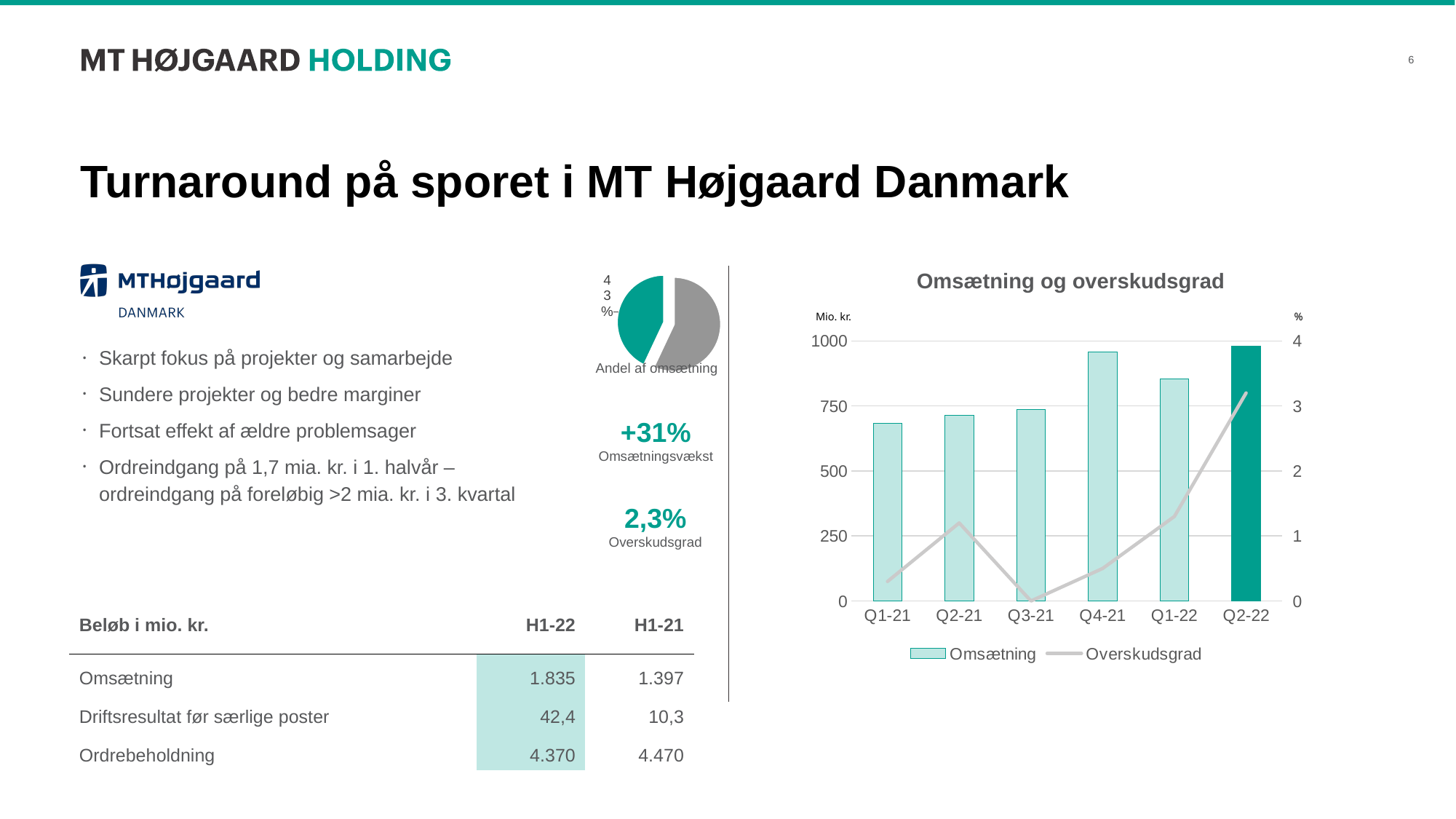
On the 'Omsætning og overskudsgrad' chart, how many series does the legend list? 2 On the 'Omsætning og overskudsgrad' chart, which quarter has the lowest Overskudsgrad? Q3-21 On the 'Omsætning og overskudsgrad' chart, which quarter has the highest Overskudsgrad? Q2-22 On the 'Omsætning og overskudsgrad' chart, is the Omsætning bar for Q4-21 larger or smaller than the bar for Q1-22? larger On the 'Omsætning og overskudsgrad' chart, how many quarters are shown on the x axis? 6 On the 'Omsætning og overskudsgrad' chart, does the Overskudsgrad line rise or fall from Q3-21 to Q2-22? rise On the 'Omsætning og overskudsgrad' chart, is the Omsætning bar for Q4-21 greater or less than 750? greater On the 'Omsætning og overskudsgrad' chart, is the Overskudsgrad for Q3-21 greater or less than 1? less What type of chart is the 'Andel af omsætning' chart? pie chart On the 'Omsætning og overskudsgrad' chart, is the Omsætning bar for Q1-21 greater or less than 750? less What share of the 'Andel af omsætning' pie chart does the teal slice represent? 43% On the 'Omsætning og overskudsgrad' chart, what unit is shown on the left axis? Mio. kr.